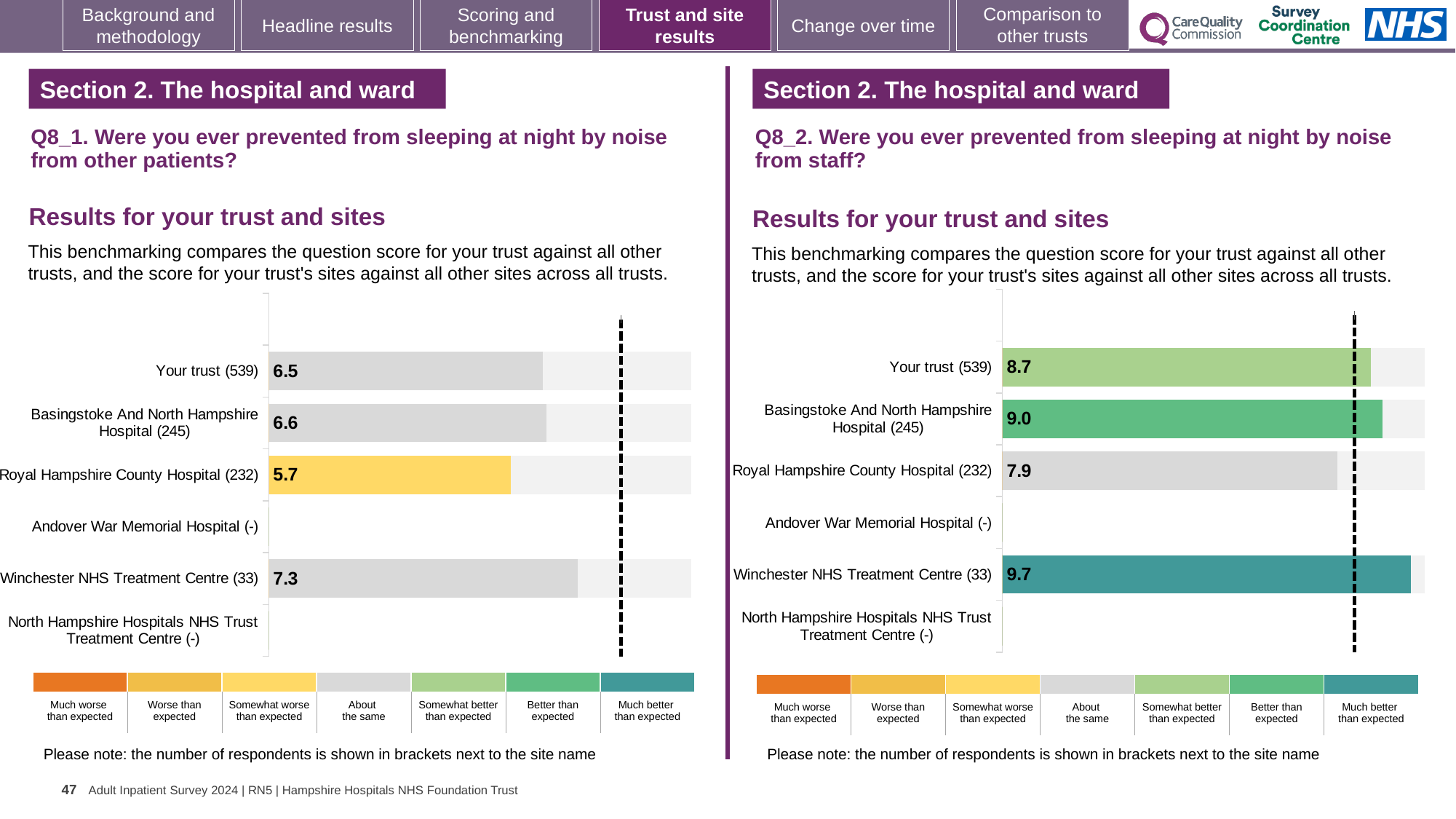
In the Q8_1 chart (left), what is the score for Your trust (539)? 6.5 In the Q8_1 chart (left), what is the score for Winchester NHS Treatment Centre (33)? 7.3 What kind of chart is used for the Q8_2 results (right)? Bar chart In the Q8_1 chart (left), what is the difference between the scores for Winchester NHS Treatment Centre (33) and Royal Hampshire County Hospital (232)? 1.6 In the Q8_2 chart (right), which has the higher score: Your trust (539) or Royal Hampshire County Hospital (232)? Your trust (539) In the Q8_2 chart (right), which site has the highest score? Winchester NHS Treatment Centre (33) In the Q8_1 chart (left), which site has the lowest score? Royal Hampshire County Hospital (232) In the Q8_2 chart (right), what is the difference between the scores for Basingstoke And North Hampshire Hospital (245) and Your trust (539)? 0.3 How many site/trust categories are listed on the y axis of the Q8_1 chart (left)? 6 In the Q8_2 chart (right), what is the score for Royal Hampshire County Hospital (232)? 7.9 In the Q8_1 chart (left), which site has the highest score? Winchester NHS Treatment Centre (33) In the Q8_2 chart (right), what is the score for Basingstoke And North Hampshire Hospital (245)? 9.0